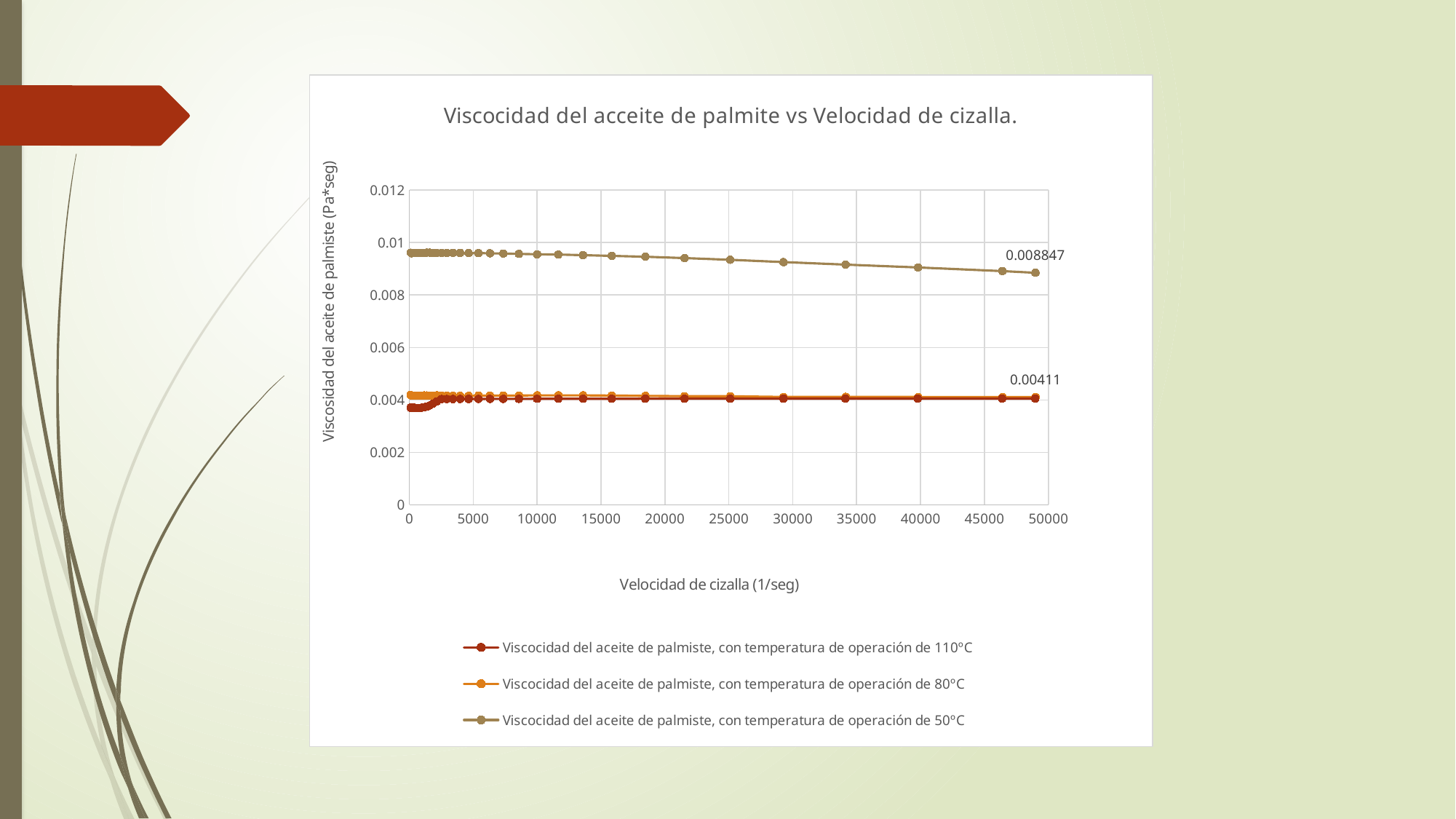
Which series has the highest viscosity across the chart? Viscocidad del aceite de palmiste, con temperatura de operación de 50°C What is the title of the chart? Viscocidad del acceite de palmite vs Velocidad de cizalla. Does the 50°C series rise or fall as shear rate increases along the x axis? falls What is the x-axis label of the chart? Velocidad de cizalla (1/seg) Which series is higher, the 50°C series or the 110°C series? the 50°C series Is the value of the 50°C series at a shear rate of 0 greater or less than 0.008? greater Is the value of the 110°C series at a shear rate of 45000 greater or less than 0.006? less How many series does the legend list? 3 What value is printed as the data label at the right end of the 50°C series? 0.008847 Is the value of the 50°C series at a shear rate of 45000 greater or less than 0.01? less What value is printed as the data label near the right end of the lower lines? 0.00411 What kind of chart is shown on the slide? line chart